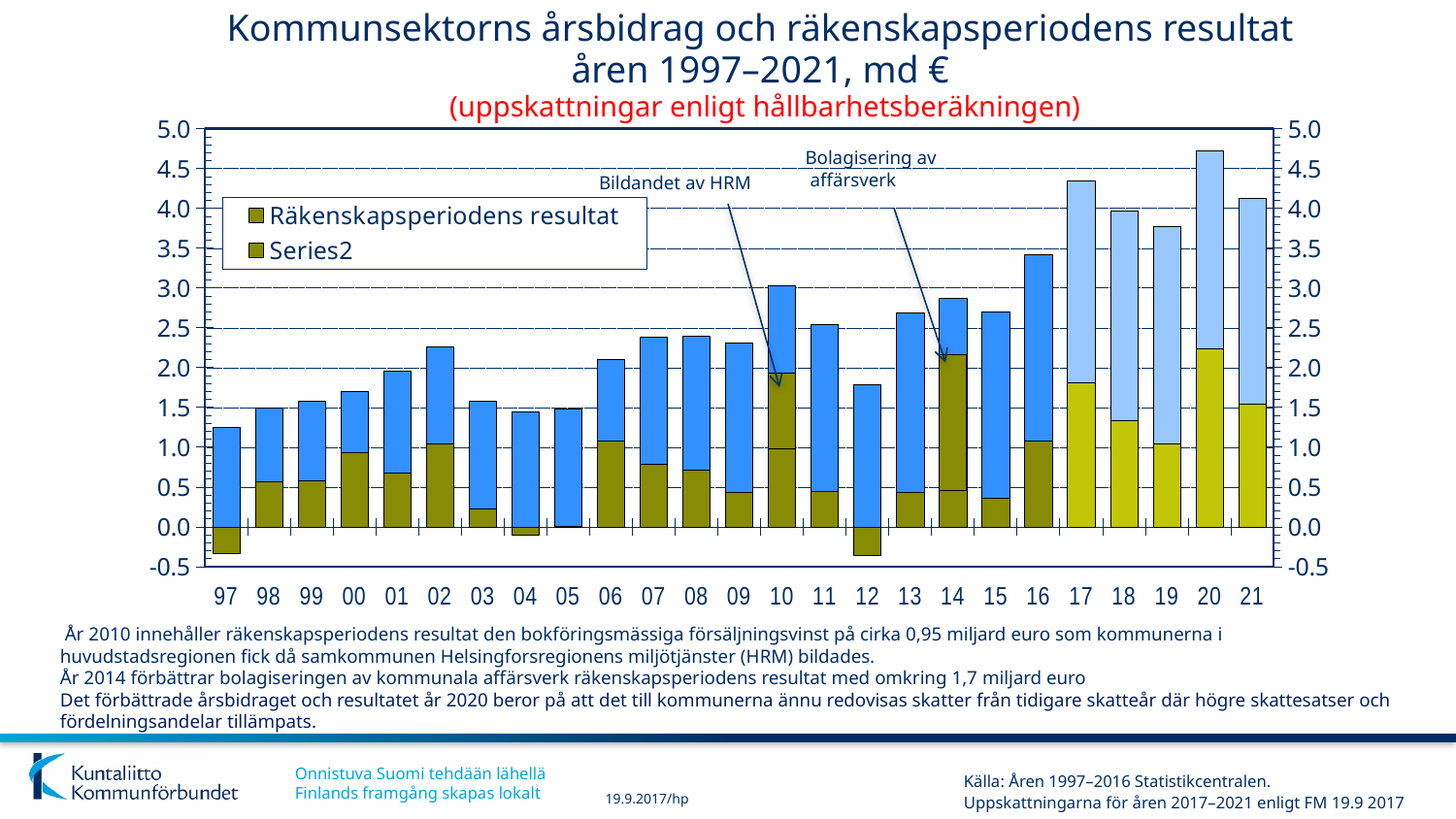
What are the two annotations pointing at the bars for 10 and 14? Bildandet av HRM; Bolagisering av affärsverk Is the blue (Series2) value for 12 greater or less than 2.0? less Is the Räkenskapsperiodens resultat value for 03 greater or less than 0.5? less How many years (categories) are shown on the x axis of the chart? 25 Which is larger, the blue (Series2) bar for 20 or for 17? 20 Is the blue (Series2) value for 17 greater or less than 4.0? greater Which is larger, the Räkenskapsperiodens resultat bar for 10 or for 11? 10 Which year has the highest blue (Series2) bar? 20 Which year has the lowest blue (Series2) bar? 97 What kind of chart is shown on the slide? Bar chart How many series does the chart legend list? 2